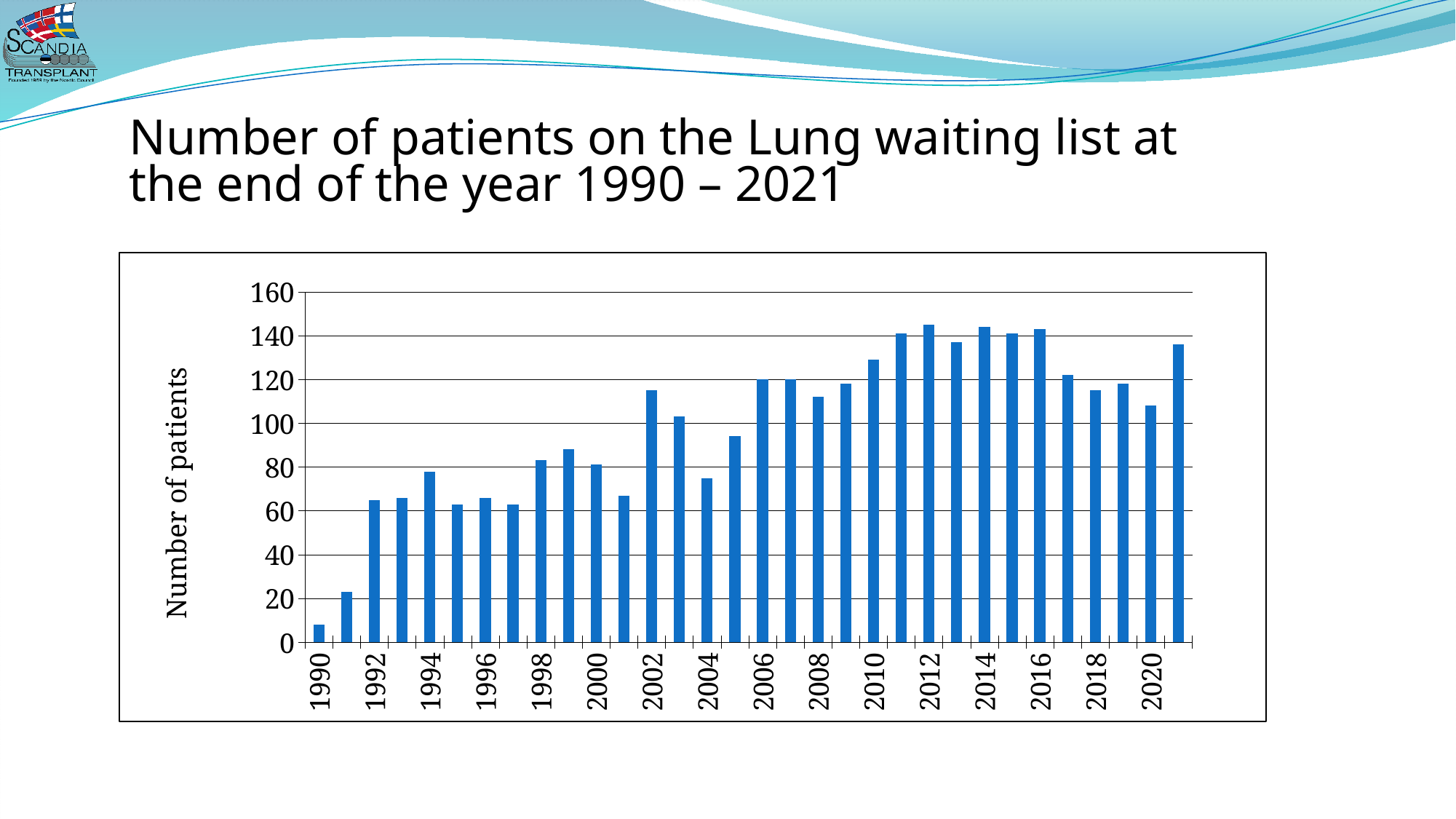
Is the value for 2021 greater or less than 120? greater How many years (bars) are plotted in the chart? 32 Is the value for 2005 greater or less than 100? less Which year has the larger value, 2002 or 2004? 2002 Which year has the larger value, 1991 or 1992? 1992 Do the values rise or fall from 1990 to 1992? rise Is the value for 2012 greater or less than 120? greater What is the label on the vertical axis of the chart? Number of patients Which year has the lowest number of patients on the lung waiting list? 1990 What kind of chart is shown on the slide? bar chart